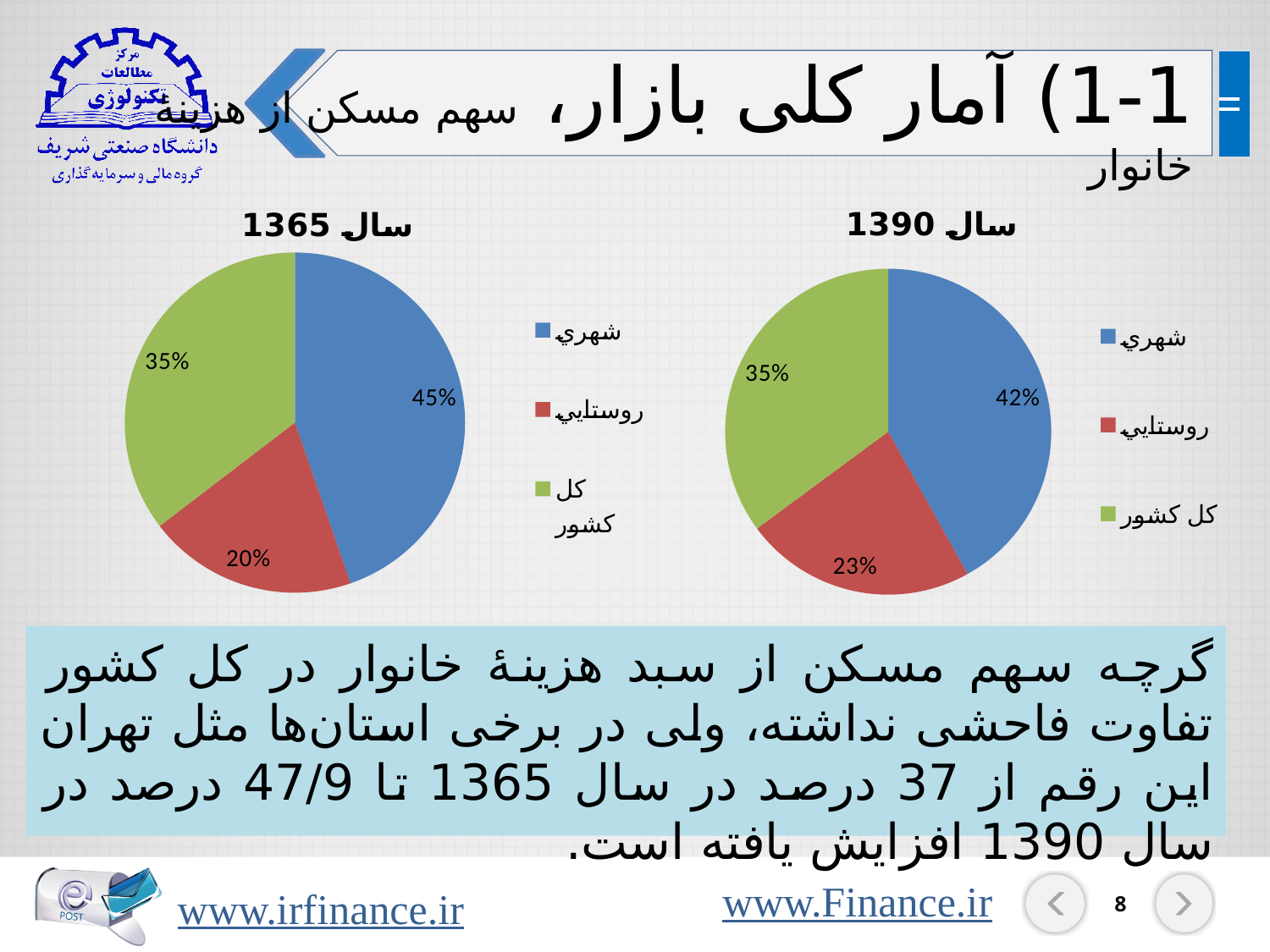
In the pie chart titled "سال 1365", what value is shown for شهري? 45% In the pie chart titled "سال 1365", what value is shown for روستايي? 20% Which is larger: the value for روستايي in the "سال 1365" chart or in the "سال 1390" chart? سال 1390 In the pie chart titled "سال 1365", which category has the largest slice? شهري How many categories does the pie chart titled "سال 1390" show? 3 In the pie chart titled "سال 1390", what value is shown for روستايي? 23% In the pie chart titled "سال 1390", what value is shown for کل کشور? 35% In the pie chart titled "سال 1365", what colour is the slice for کل کشور? Green In the pie chart titled "سال 1390", what value is shown for شهري? 42% What type of chart is the chart titled "سال 1365"? Pie chart In the pie chart titled "سال 1365", what is the difference between the values for شهري and روستايي? 25% In the pie chart titled "سال 1390", which category has the smallest slice? روستايي